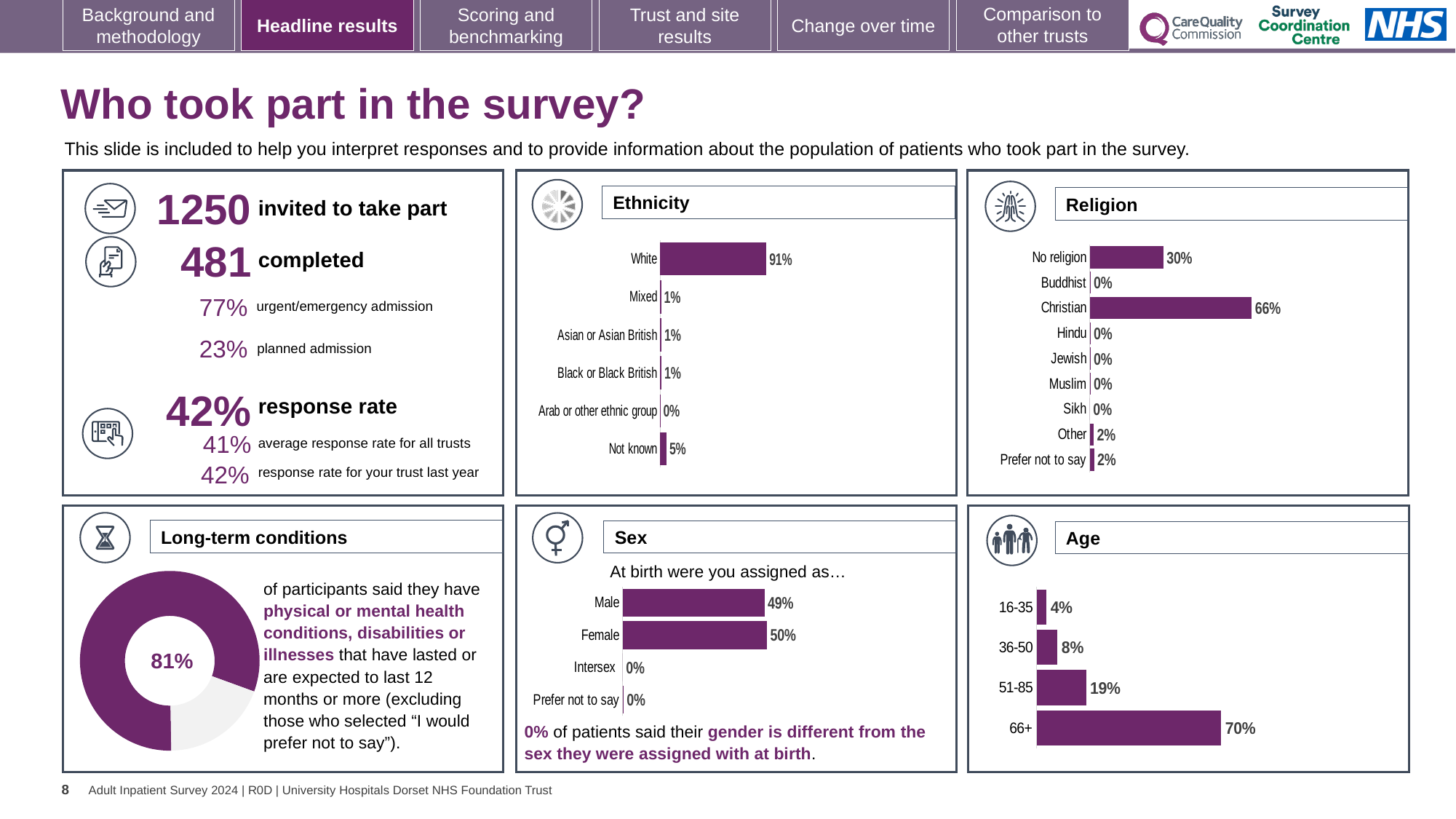
In the Religion chart, what is the difference between Christian and No religion? 36% In the Age chart, which age group has the lowest value? 16-35 In the Ethnicity chart, what is the value for White? 91% In the Religion chart, what is the value for Christian? 66% In the Age chart, what is the value for 66+? 70% In the Sex chart, which is larger, Male or Female? Female In the Sex chart, what is the value for Female? 50% In the Religion chart, how many categories are shown? 9 What kind of chart is used in the Long-term conditions panel? Doughnut chart In the Ethnicity chart, which category has the highest value? White In the Age chart, do the values rise or fall as you move from 16-35 to 66+? rise In the Ethnicity chart, how many categories are shown? 6